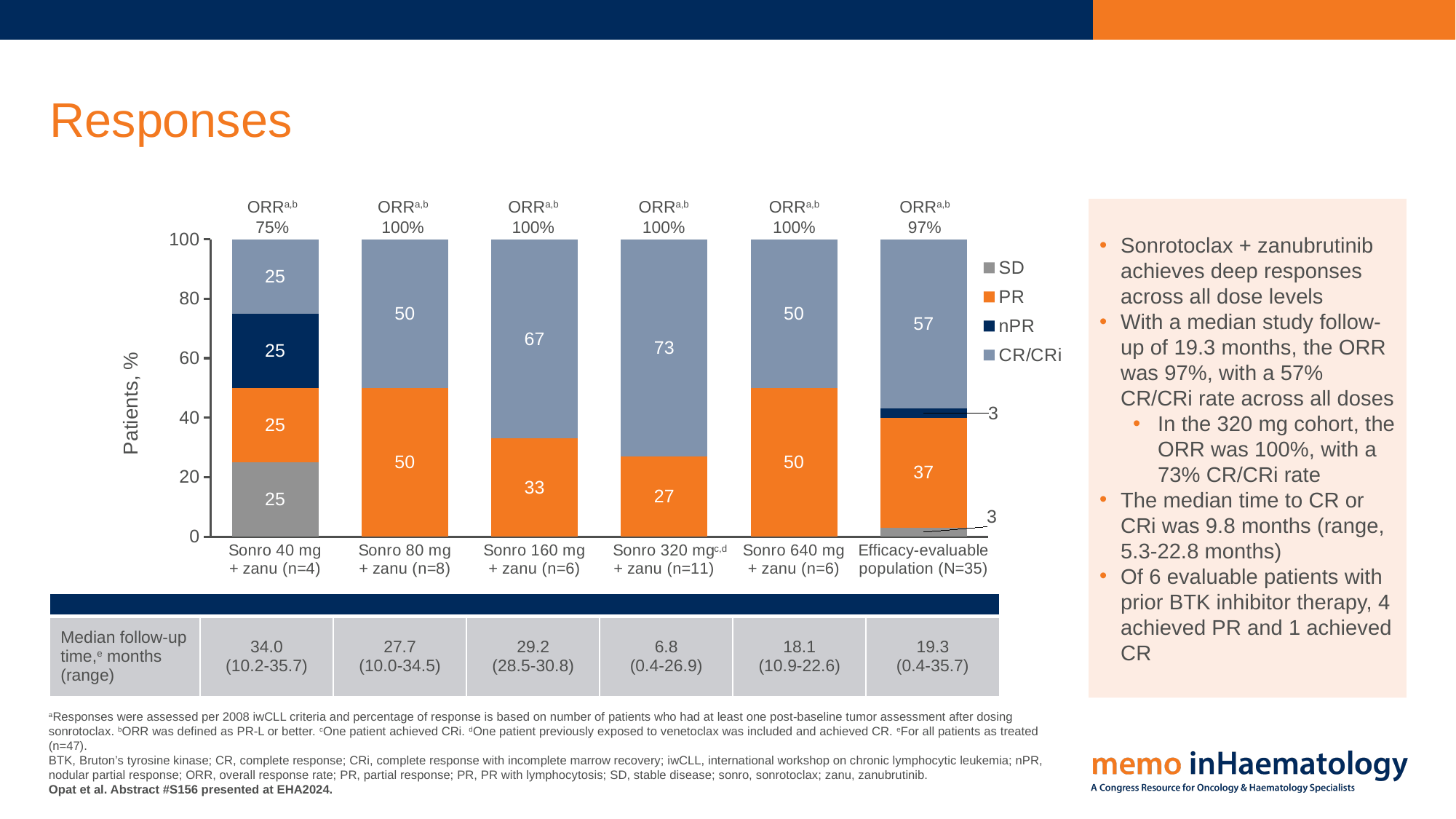
What is the total of the stacked bar for Sonro 40 mg + zanu (n=4)? 100 Is the CR/CRi percentage larger for Sonro 160 mg + zanu (n=6) or for Sonro 80 mg + zanu (n=8)? Sonro 160 mg + zanu (n=6) Which cohort has the highest CR/CRi percentage? Sonro 320 mg + zanu (n=11) What is the label of the y axis? Patients, % What is the CR/CRi percentage for the Sonro 320 mg + zanu (n=11) cohort? 73 How many series does the legend list? 4 How many cohorts (bars) are shown on the x axis? 6 What kind of chart is shown on the slide? Stacked bar chart In the Sonro 320 mg + zanu (n=11) cohort, what is the difference between the CR/CRi and PR percentages? 46 Which cohort has the lowest CR/CRi percentage? Sonro 40 mg + zanu (n=4) What is the PR percentage for the Efficacy-evaluable population (N=35)? 37 What is the ORR shown above the Sonro 40 mg + zanu (n=4) bar? 75%